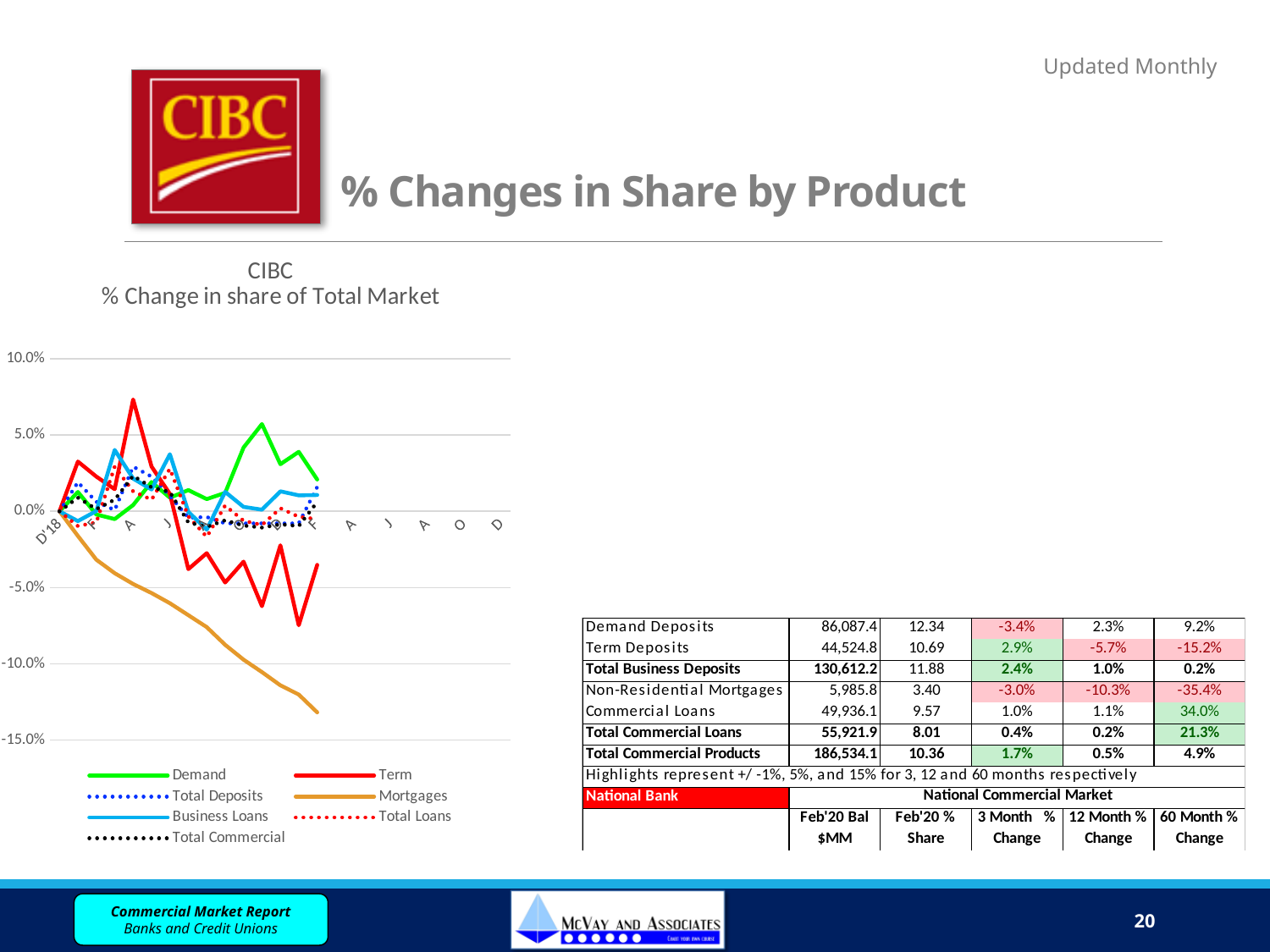
How many series does the chart legend list? 7 What value do all the series start at for D'18? 0.0% What is the title of the chart? CIBC % Change in share of Total Market Does the Mortgages line rise or fall along the x axis? fall Which series reaches the highest value on the chart? Term Is the final value of the Mortgages line greater or less than -10.0%? less What type of chart is shown on the slide? line chart At the end of the plotted period, which is higher, the Demand line or the Mortgages line? Demand What is the highest value shown on the y axis? 10.0% Is the peak value of the Term line greater or less than 5.0%? greater Is the lowest value of the Term line greater or less than -5.0%? less Which series reaches the lowest value on the chart? Mortgages